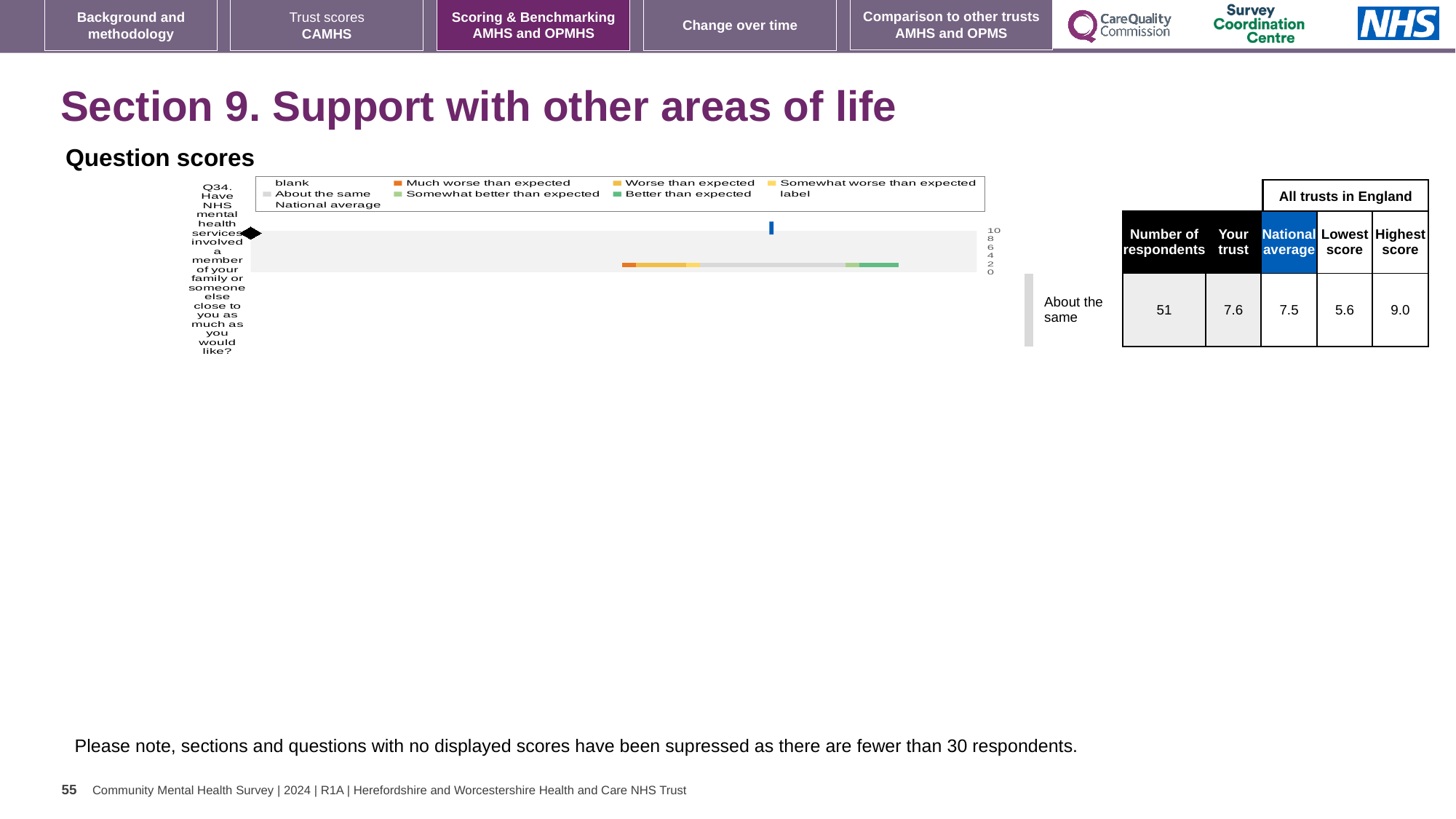
What is the highest tick value shown on the chart's score axis? 10 Which question number is plotted in the Question scores chart? Q34 What benchmark category is the trust's Q34 score assigned to, as labelled next to the chart? About the same Is the 'Your trust' score for Q34 higher or lower than the national average? higher How many questions are plotted in the Question scores chart? 1 In the table beside the chart, what is the lowest score among all trusts in England for Q34? 5.6 In the table beside the chart, what is the highest score among all trusts in England for Q34? 9.0 In the table beside the chart, what is the number of respondents for Q34? 51 What is the difference between the highest score and the lowest score for Q34 in the table beside the chart? 3.4 In the table beside the chart, what is the 'Your trust' score for Q34? 7.6 What kind of chart is used to show the Q34 question score? bar chart In the table beside the chart, what is the national average score for Q34? 7.5